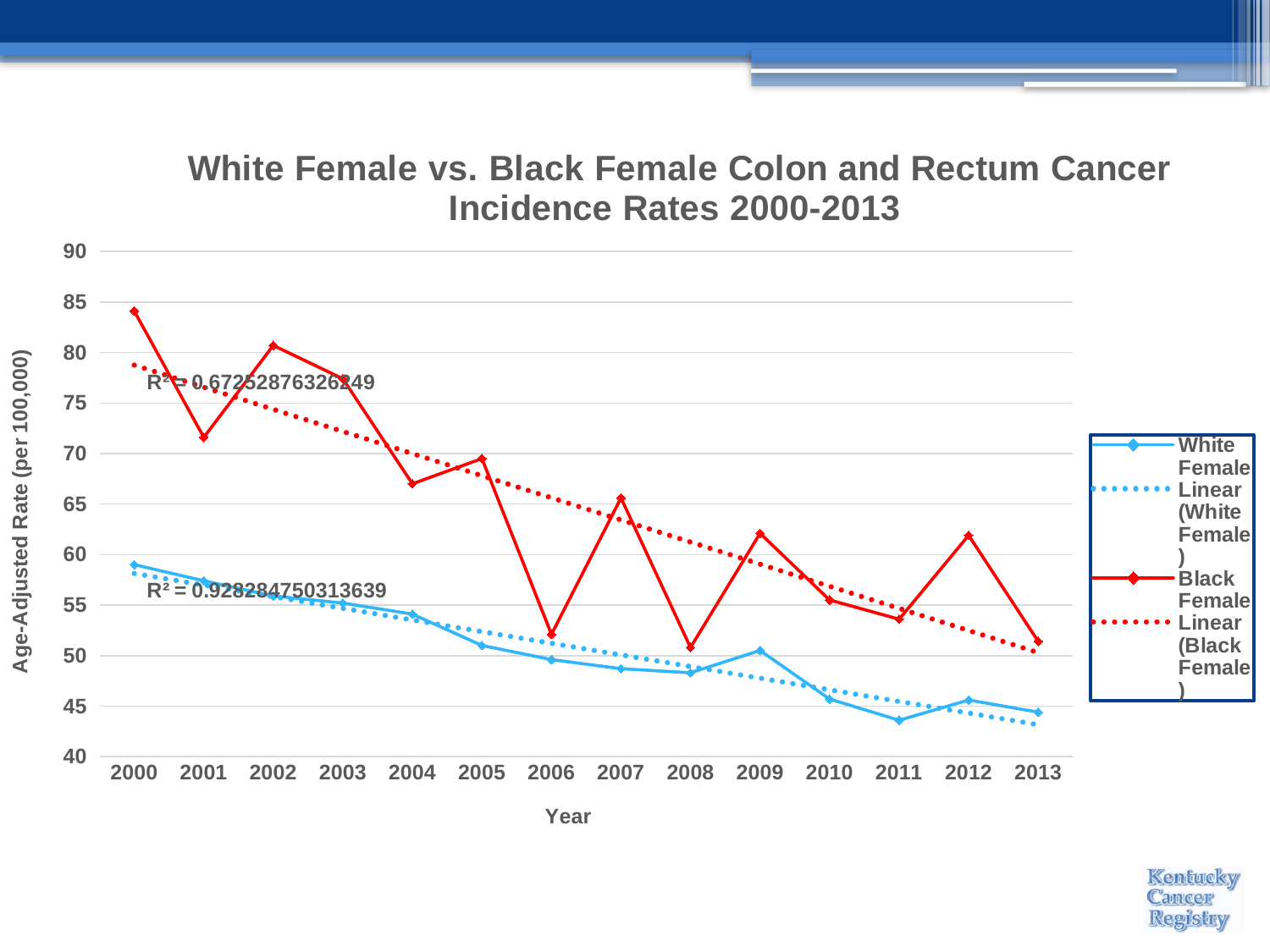
In which year is the Black Female incidence rate highest? 2000 Is the Black Female value for 2006 greater or less than 55? less What kind of chart is shown on the slide? line chart Is the White Female value for 2013 greater or less than 50? less How many years are plotted along the x axis? 14 In 2000, which series has the larger value, White Female or Black Female? Black Female Is the Black Female value for 2012 greater or less than 60? greater What is the title of the chart? White Female vs. Black Female Colon and Rectum Cancer Incidence Rates 2000-2013 How many entries does the legend list? 4 Do the White Female incidence rates generally rise or fall from 2000 to 2013? fall In which year is the White Female incidence rate highest? 2000